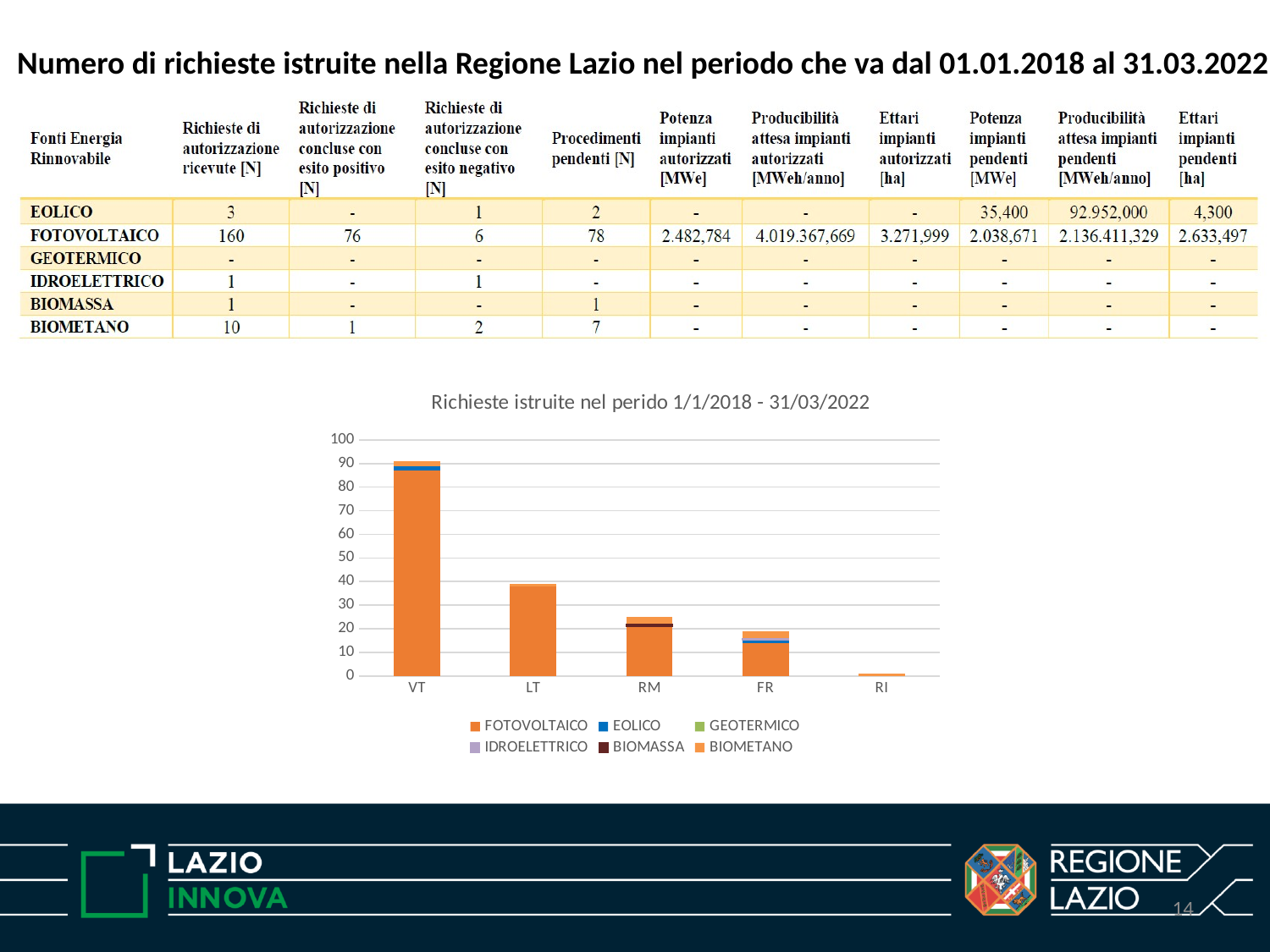
Which category has the shortest bar in the chart? RI Is the total bar for LT greater or less than 50? less Is the total bar for RM greater or less than 20? greater How many categories are shown on the x axis of the chart? 5 Which category has the tallest bar in the chart? VT What kind of chart is shown on the slide? bar chart Is the total bar for VT greater or less than 80? greater What is the title of the chart? Richieste istruite nel perido 1/1/2018 - 31/03/2022 Which bar is taller, LT or RM? LT How many series does the chart legend list? 6 Do the bar totals rise or fall moving from VT to RI along the x axis? fall